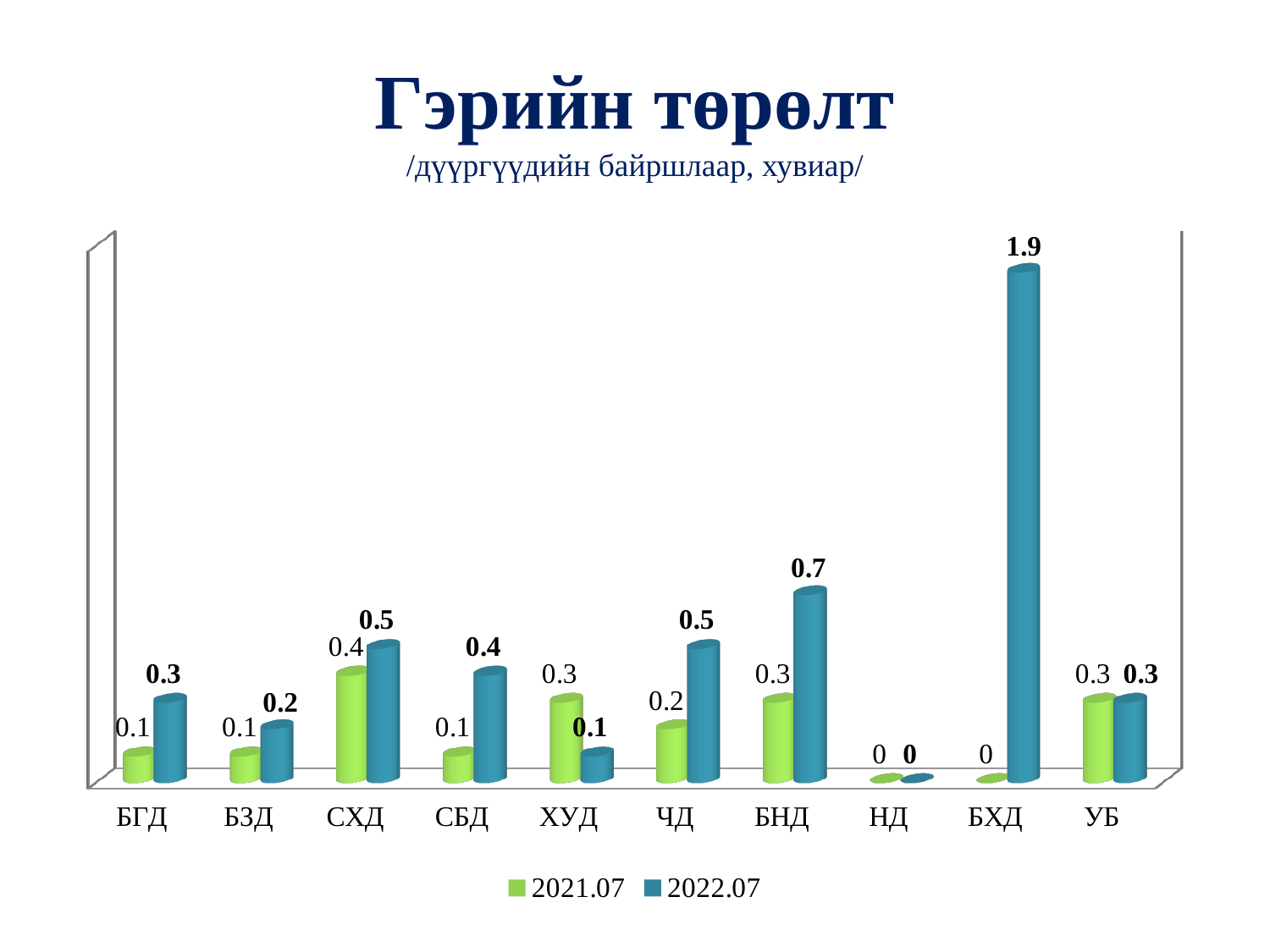
What is the value for БНД in the 2022.07 series? 0.7 How many categories are shown on the x axis? 10 Which category has the highest value in the 2021.07 series? СХД What is the difference between the 2022.07 and 2021.07 values for БХД? 1.9 Which category has the highest value in the 2022.07 series? БХД What is the value for СХД in the 2021.07 series? 0.4 What is the value for БХД in the 2022.07 series? 1.9 For ХУД, which series has the larger value, 2021.07 or 2022.07? 2021.07 How many series does the legend list? 2 For СБД, which series has the larger value, 2021.07 or 2022.07? 2022.07 What kind of chart is shown on the slide? Bar chart What is the difference between the 2022.07 and 2021.07 values for БНД? 0.4